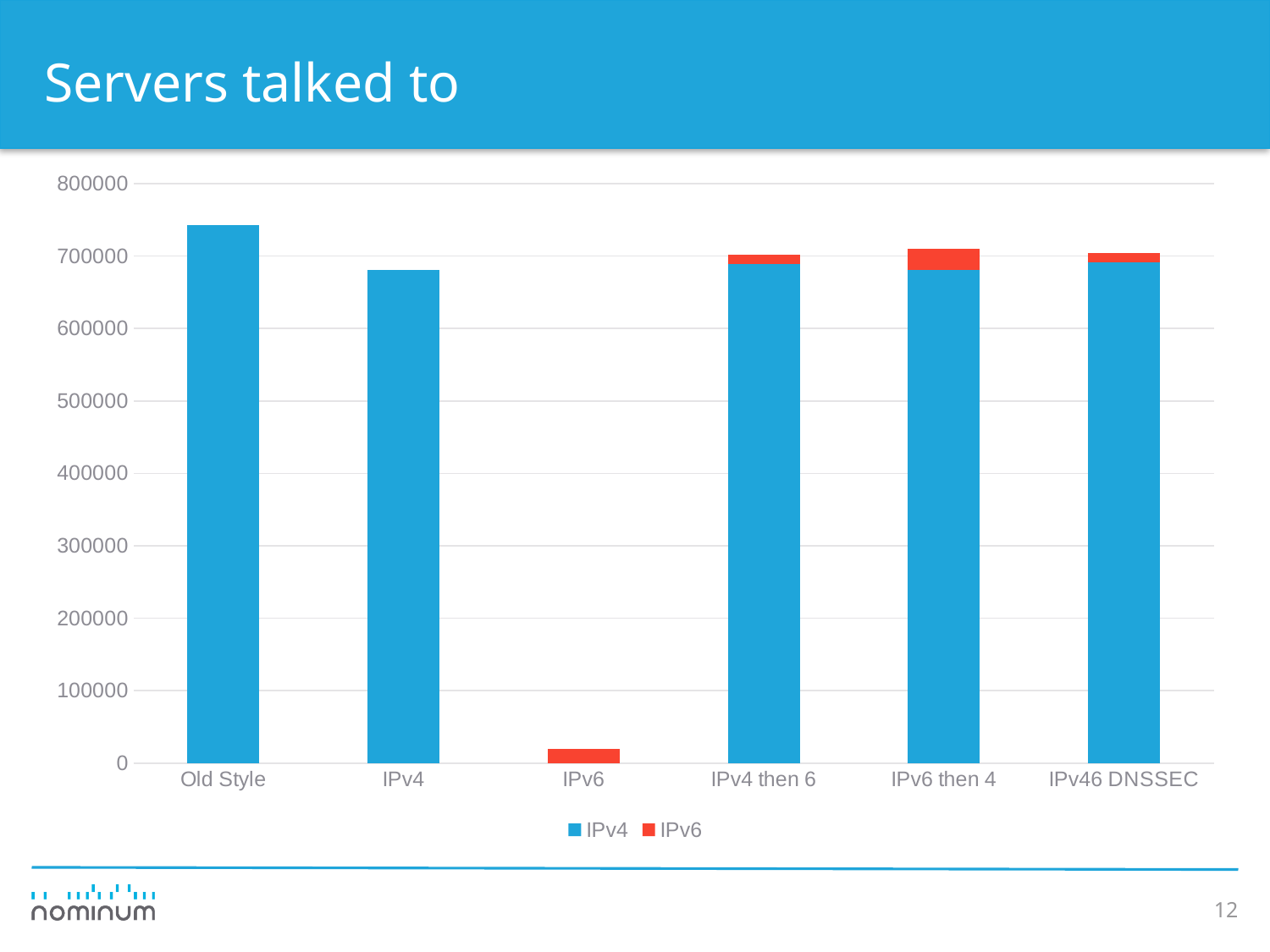
How many categories are shown on the x axis? 6 What kind of chart is shown on the slide? stacked bar chart Which category has the tallest bar overall? Old Style Is the value for IPv6 greater or less than 100000? less Which bar is taller, Old Style or IPv4? Old Style Which category has the shortest bar overall? IPv6 How many series does the legend list? 2 Is the IPv4 value for the IPv4 category greater or less than 700000? less What is the title of the chart? Servers talked to Which category has the largest IPv6 (red) segment among the stacked bars with both series? IPv6 then 4 Is the total value for Old Style greater or less than 700000? greater Which colour represents the IPv6 series in the chart? red